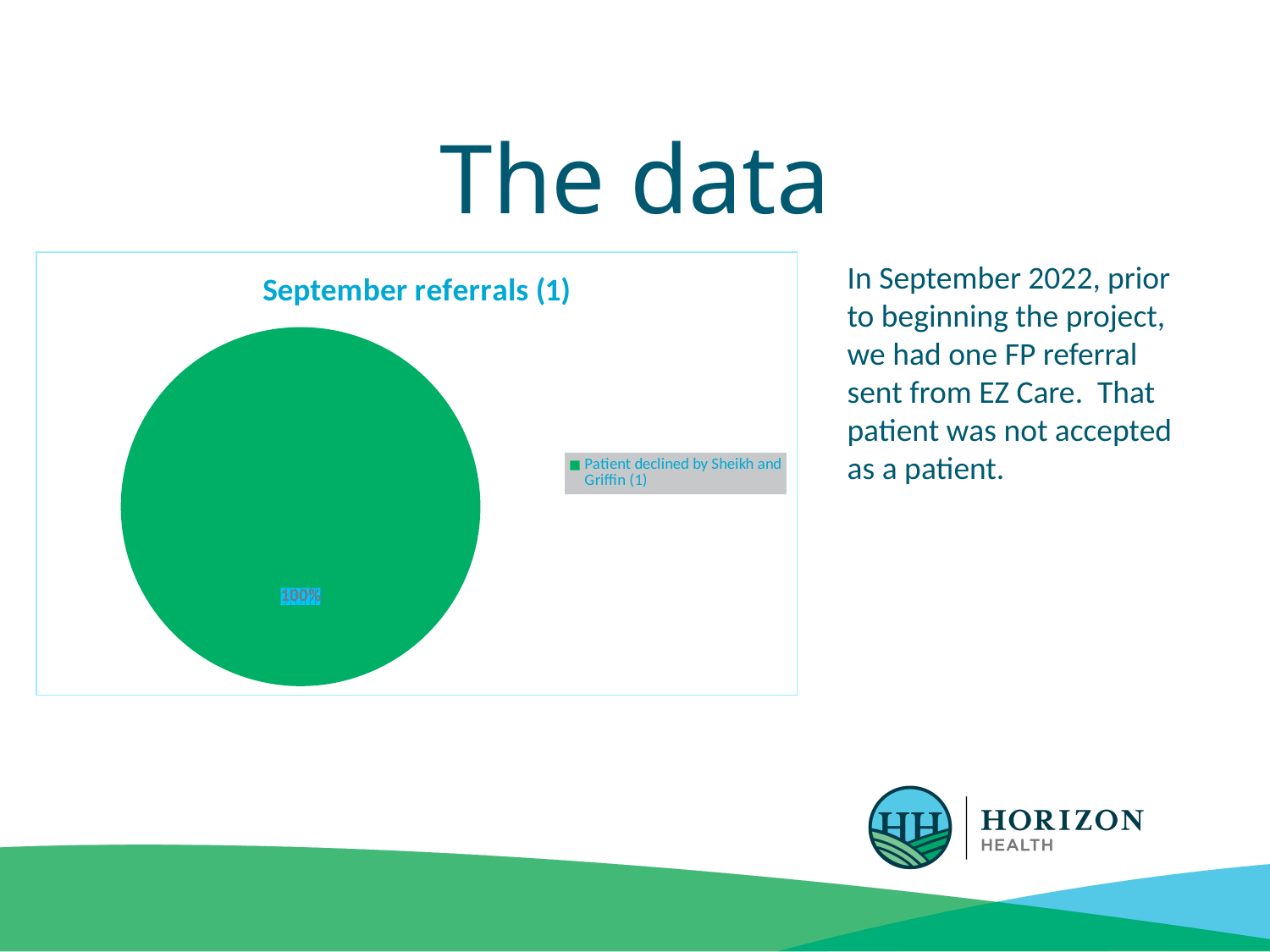
How many slices does the pie chart have? 1 What percentage is printed as the data label on the pie slice? 100% What is the title of the chart? September referrals (1) What share of the pie does the slice 'Patient declined by Sheikh and Griffin (1)' represent? 100% How many entries does the legend list? 1 What kind of chart is shown on the slide? pie chart What is the label of the only legend entry in the chart? Patient declined by Sheikh and Griffin (1)